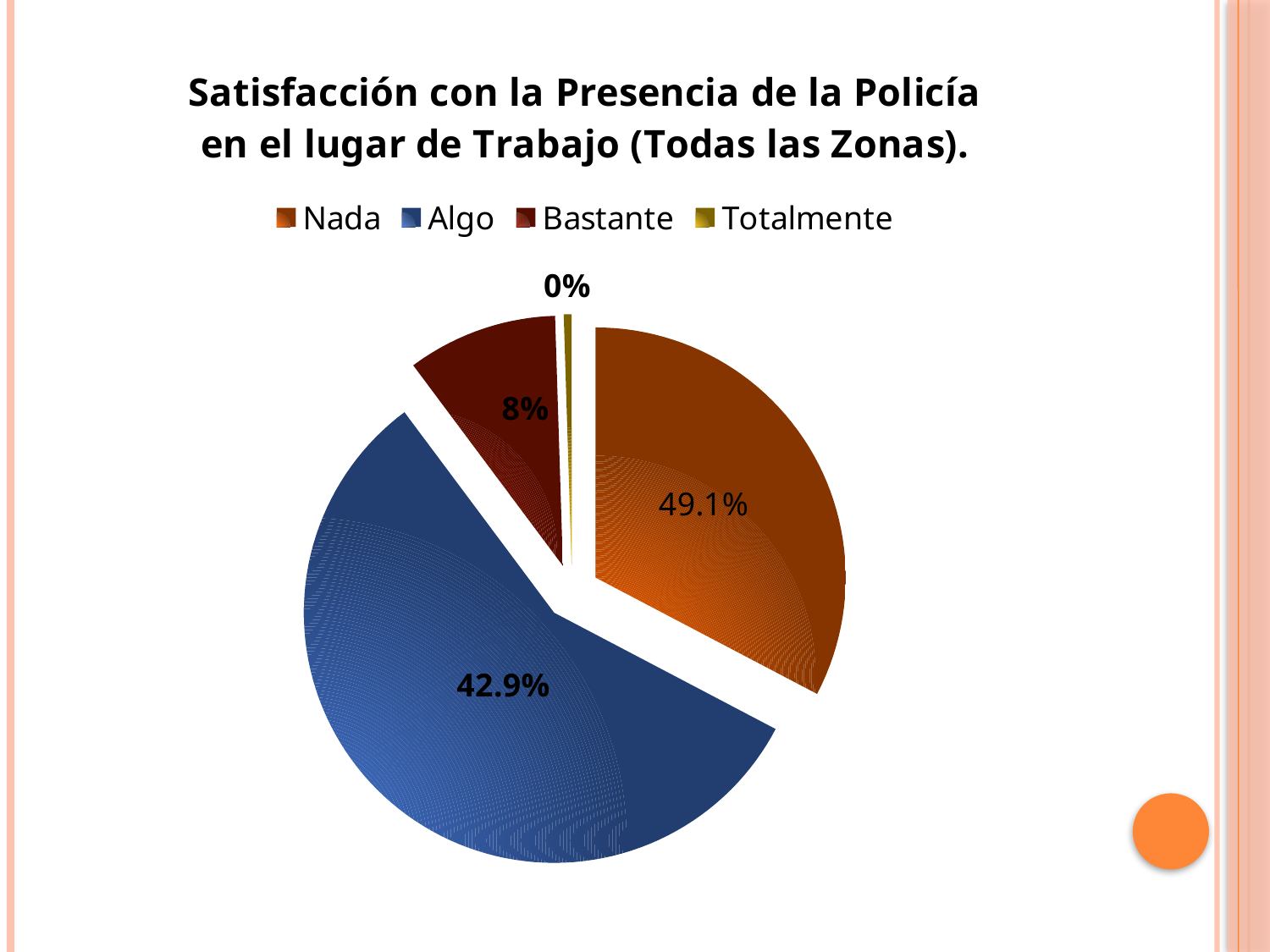
What is the value for Nada? 49.1% What is the title of the chart? Satisfacción con la Presencia de la Policía en el lugar de Trabajo (Todas las Zonas). Which is larger, the value for Algo or the value for Bastante? Algo Which legend entry is shown in blue? Algo What is the value for Algo? 42.9% What is the difference between the values for Nada and Algo? 6.2% Which category has the largest share of the pie? Algo What kind of chart is shown on the slide? Pie chart How many categories does the pie chart show? 4 What is the value for Bastante? 8% What is the value for Totalmente? 0% Which category has the smallest share of the pie? Totalmente